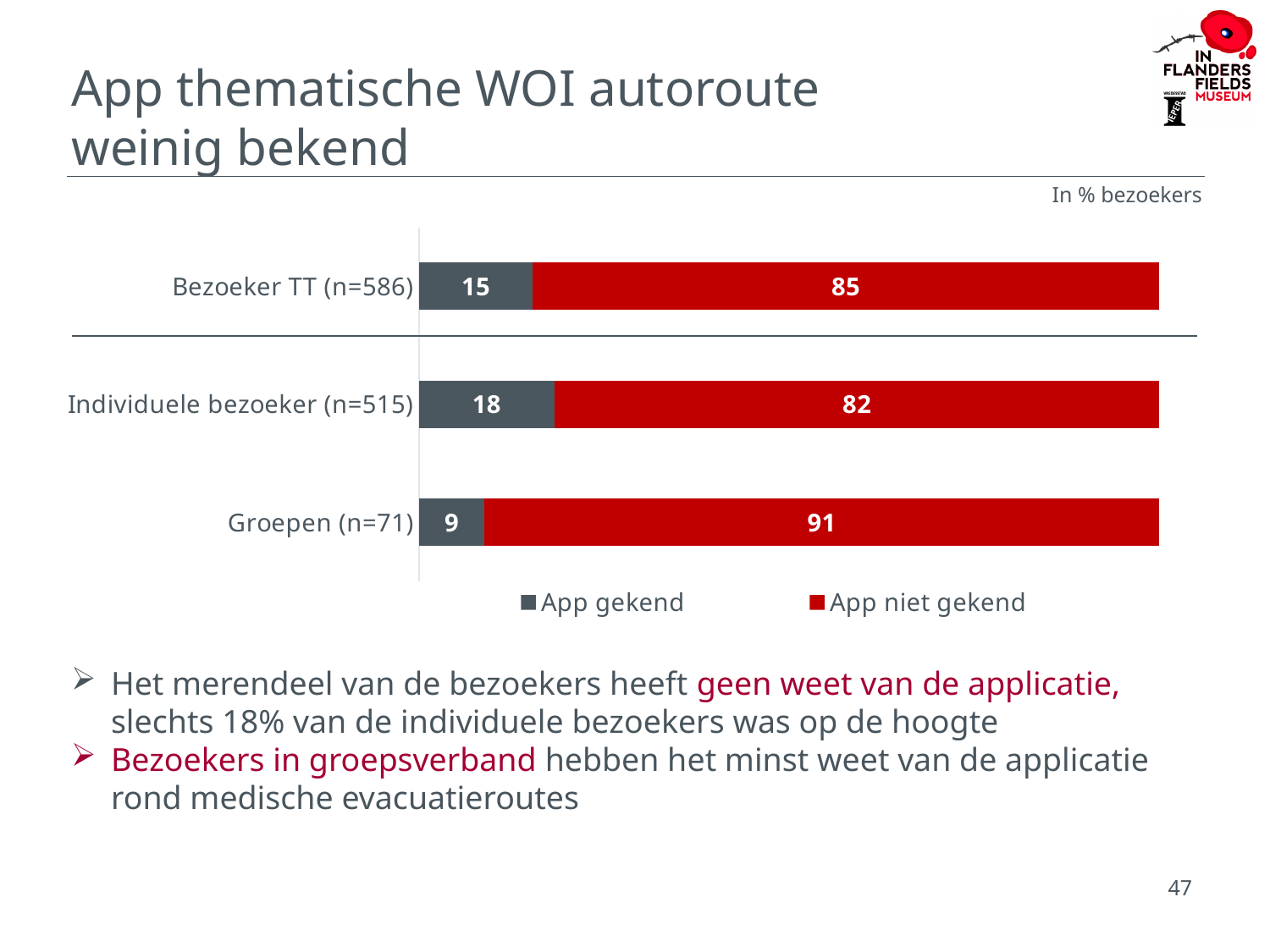
What is the total of the stacked bar for Individuele bezoeker (n=515)? 100 What kind of chart is shown on the slide? Stacked bar chart What is the value for "App niet gekend" for Groepen (n=71)? 91 What is the value for "App gekend" for Groepen (n=71)? 9 How many categories are shown in the chart? 3 What is the value for "App gekend" for Bezoeker TT (n=586)? 15 What is the value for "App niet gekend" for Individuele bezoeker (n=515)? 82 Which is larger: the "App gekend" value for Bezoeker TT (n=586) or for Individuele bezoeker (n=515)? Individuele bezoeker (n=515) Which category has the highest value for "App gekend"? Individuele bezoeker (n=515) What is the difference between the "App niet gekend" values for Groepen (n=71) and Bezoeker TT (n=586)? 6 How many series does the legend list? 2 Which category has the lowest value for "App gekend"? Groepen (n=71)